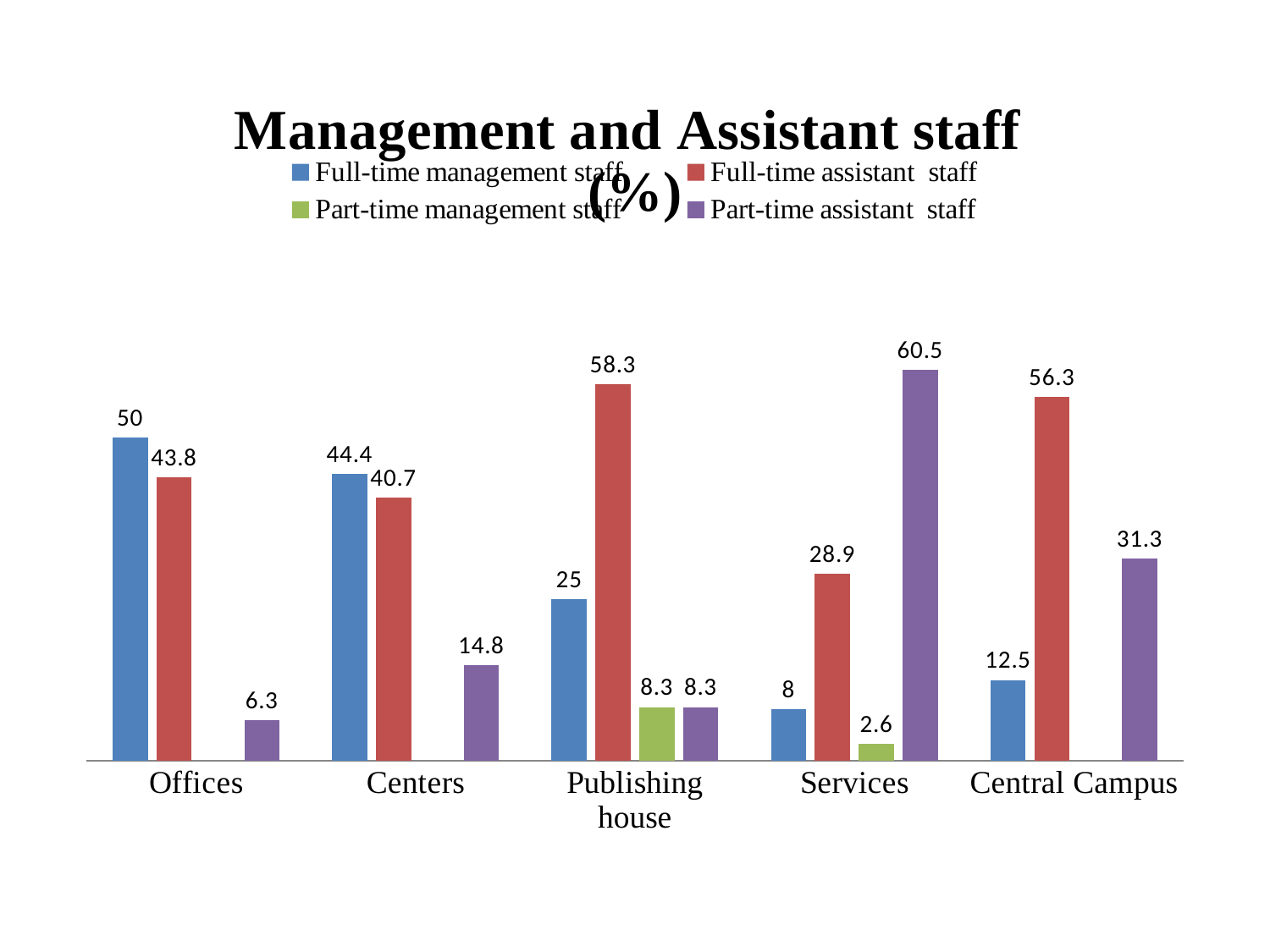
How many categories are shown on the x axis? 5 What is the value for Full-time assistant staff in Central Campus? 56.3 Which category has the highest value for Full-time assistant staff? Publishing house What is the value for Part-time assistant staff in Services? 60.5 Which category has the lowest value for Full-time management staff? Services What kind of chart is shown on the slide? Bar chart What colour represents Part-time assistant staff in the chart? Purple What is the value for Part-time management staff in Publishing house? 8.3 What is the difference between Full-time assistant staff and Full-time management staff in Central Campus? 43.8 How many series does the legend list? 4 Which is larger in Centers: Full-time management staff or Full-time assistant staff? Full-time management staff What is the value for Full-time management staff in Offices? 50